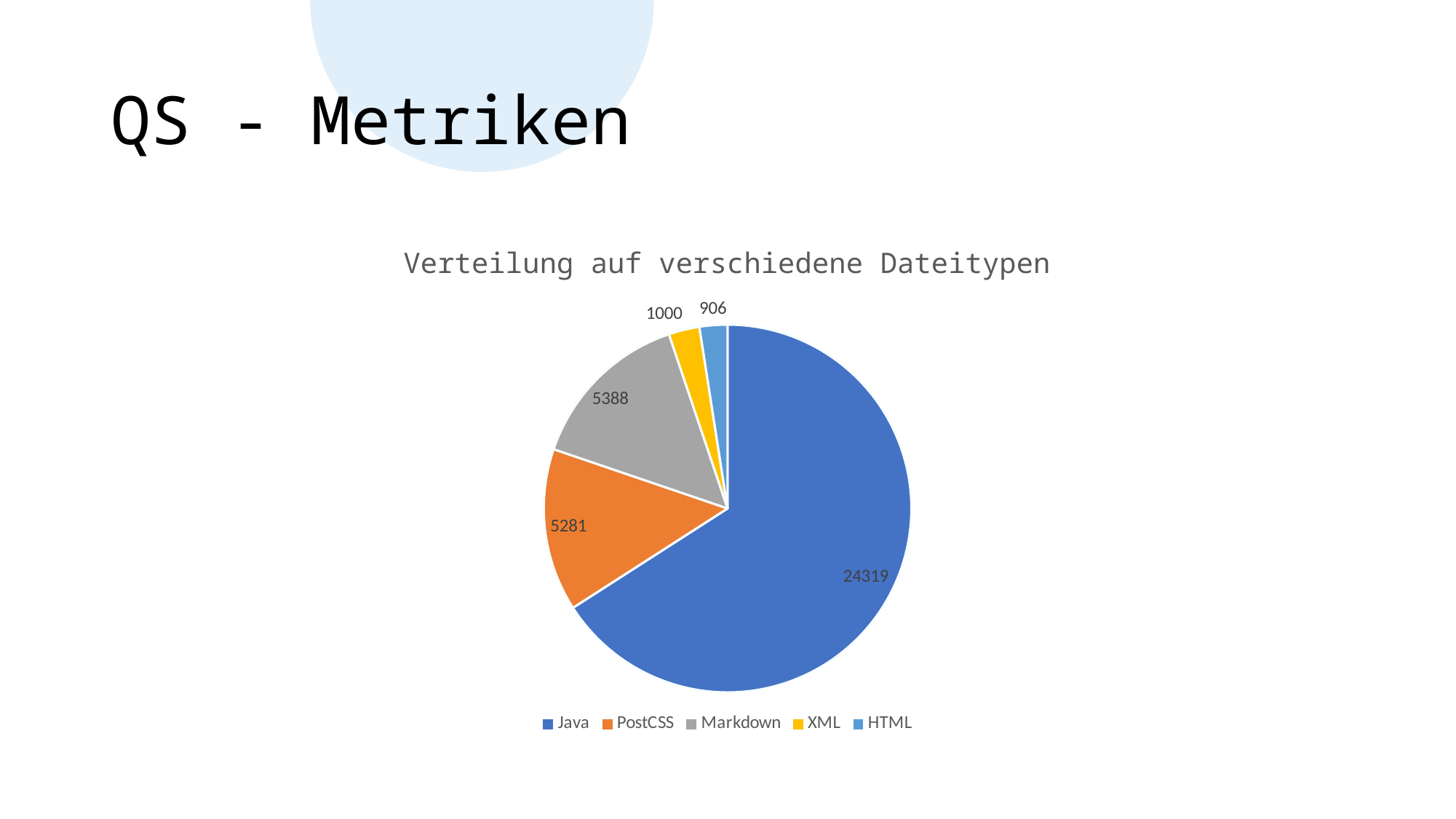
What is the value for Java? 24319 What is the value for PostCSS? 5281 Which file type has the largest slice? Java What is the value for Markdown? 5388 What is the value for XML? 1000 What is the difference between the values for Markdown and PostCSS? 107 Which file type has the smallest slice? HTML How many file types does the legend list? 5 What is the title of the chart? Verteilung auf verschiedene Dateitypen What kind of chart is shown on the slide? pie chart Which is larger, the value for XML or the value for HTML? XML What is the value for HTML? 906